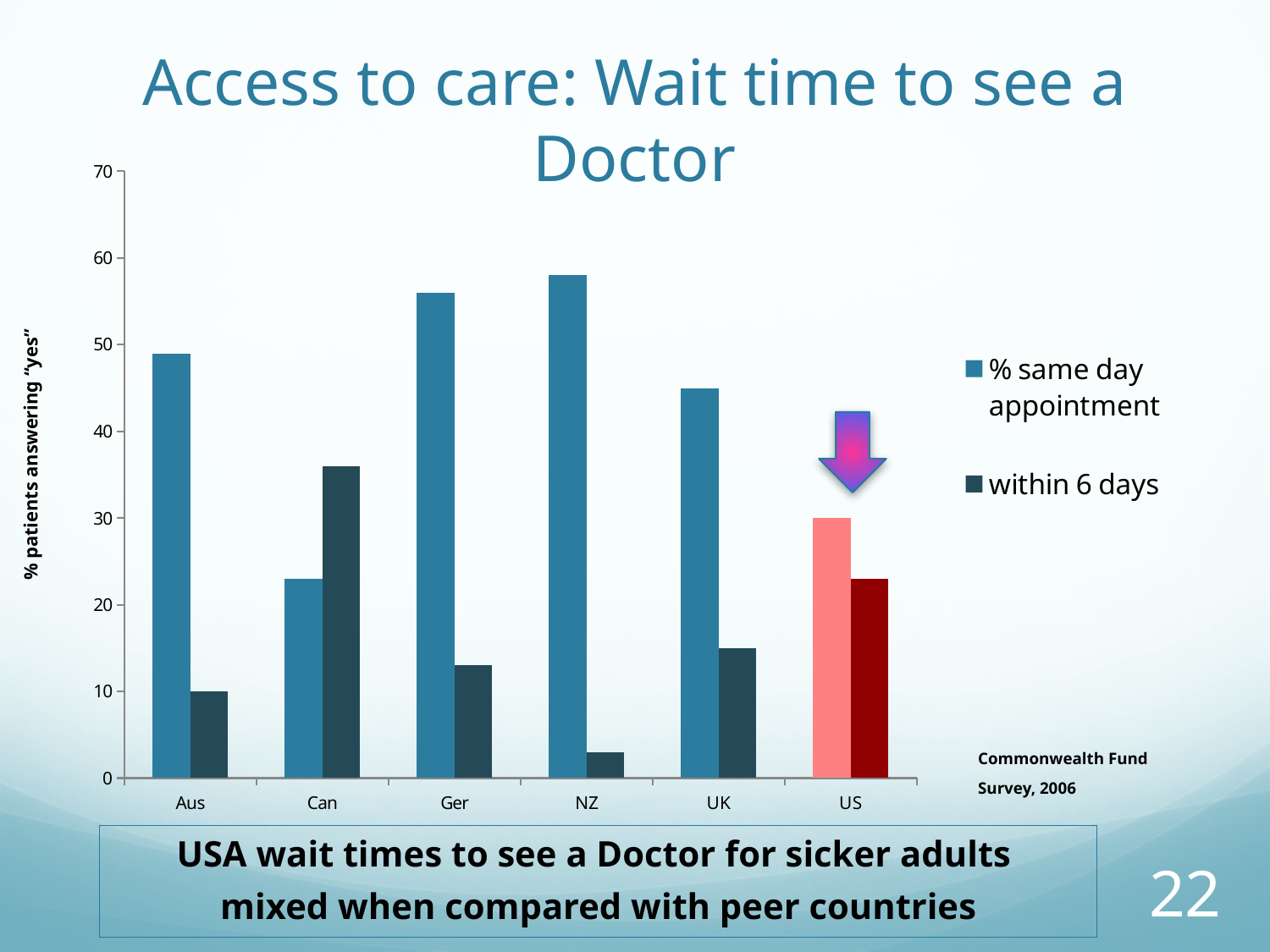
Is the "within 6 days" value for Can greater or less than 30? greater Is the "within 6 days" value for NZ greater or less than 10? less Is the "% same day appointment" value for UK greater or less than 40? greater Which is larger, the "% same day appointment" value for Ger or for UK? Ger Which country has the lowest value for "% same day appointment"? Can How many countries are shown on the x axis of the chart? 6 Which country has the lowest value for "within 6 days"? NZ What is the label on the chart's vertical axis? % patients answering "yes" What kind of chart is shown on the slide? bar chart How many series does the chart's legend list? 2 Which country has the highest value for "within 6 days"? Can